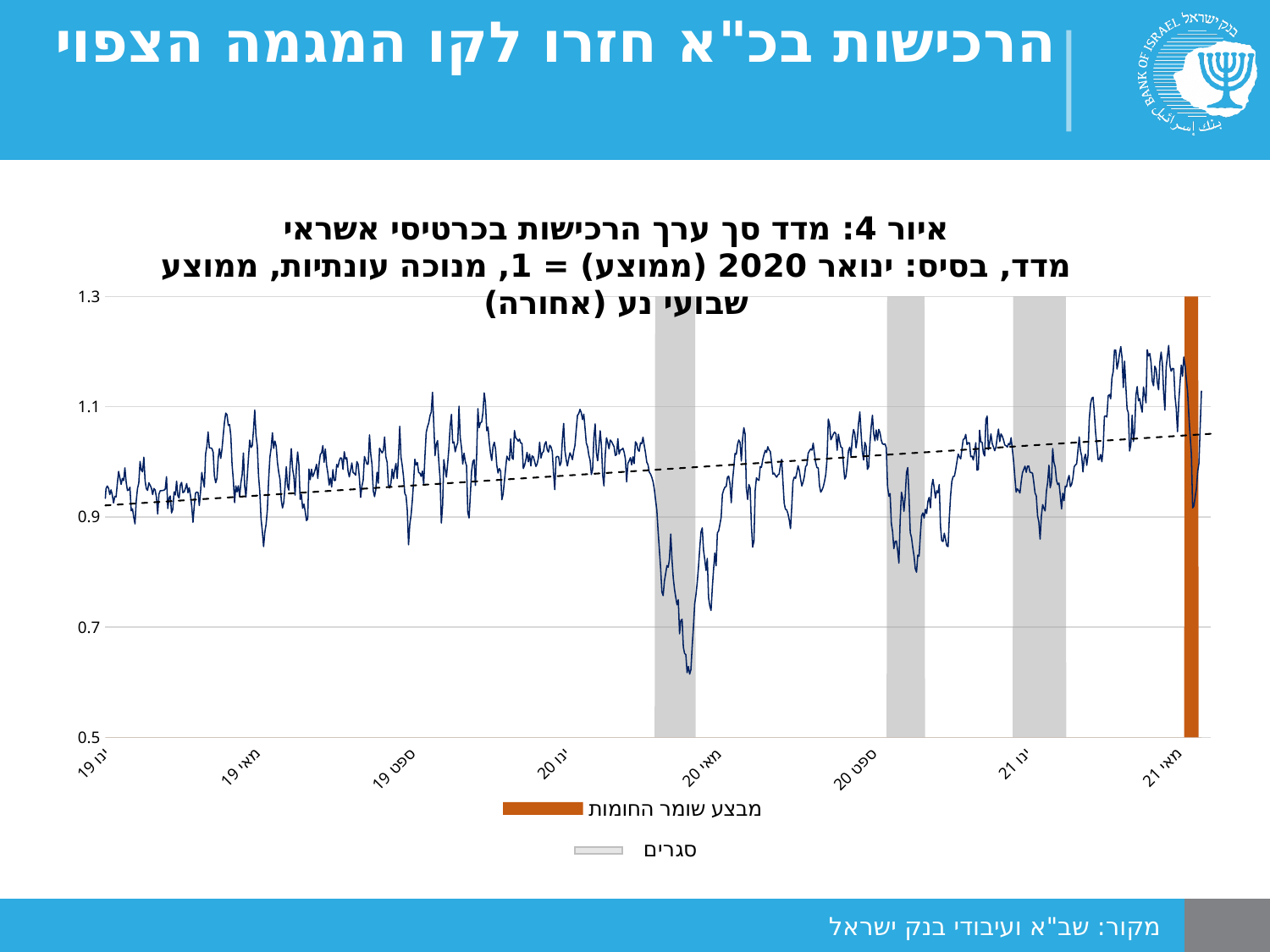
Is the peak of the line reached in 2021 greater or less than 1.1? greater Does the dashed trend line rise or fall from left to right? rise How many grey shaded lockdown (סגרים) bands are drawn on the chart? 3 What is the highest value shown on the y axis? 1.3 Is the lowest point of the line, reached around מאי 20, greater or less than 0.7? less How many labels are shown on the x axis? 8 What is the first label on the x axis? ינו 19 Around which x-axis label does the line reach its lowest value? מאי 20 Is the line's value around ינו 21 higher or lower than its lowest value around מאי 20? higher What kind of chart is shown on the slide? line chart How many entries does the legend list? 2 Is the value of the line at ינו 19 greater or less than 0.7? greater